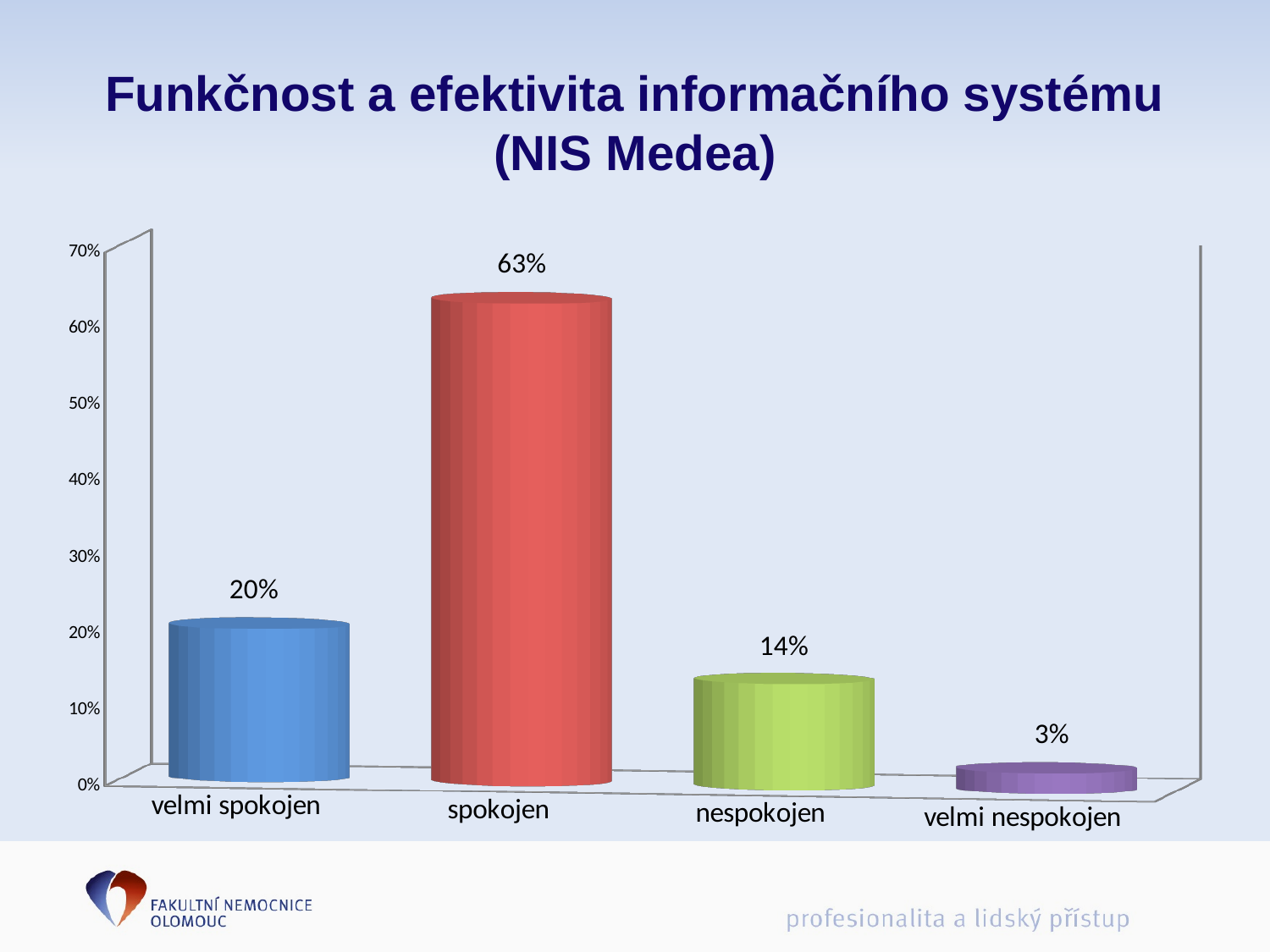
Which category has the lowest value? velmi nespokojen Is the value for "spokojen" greater or less than 60%? greater Which category has the highest value? spokojen What is the difference between the values for "spokojen" and "velmi spokojen"? 43% What is the value for "velmi spokojen"? 20% What is the value for "spokojen"? 63% What kind of chart is shown on the slide? bar chart How many categories are shown on the x axis? 4 Which is larger, the value for "velmi spokojen" or the value for "nespokojen"? velmi spokojen What is the value for "velmi nespokojen"? 3% What is the title of the slide containing the chart? Funkčnost a efektivita informačního systému (NIS Medea) What is the value for "nespokojen"? 14%